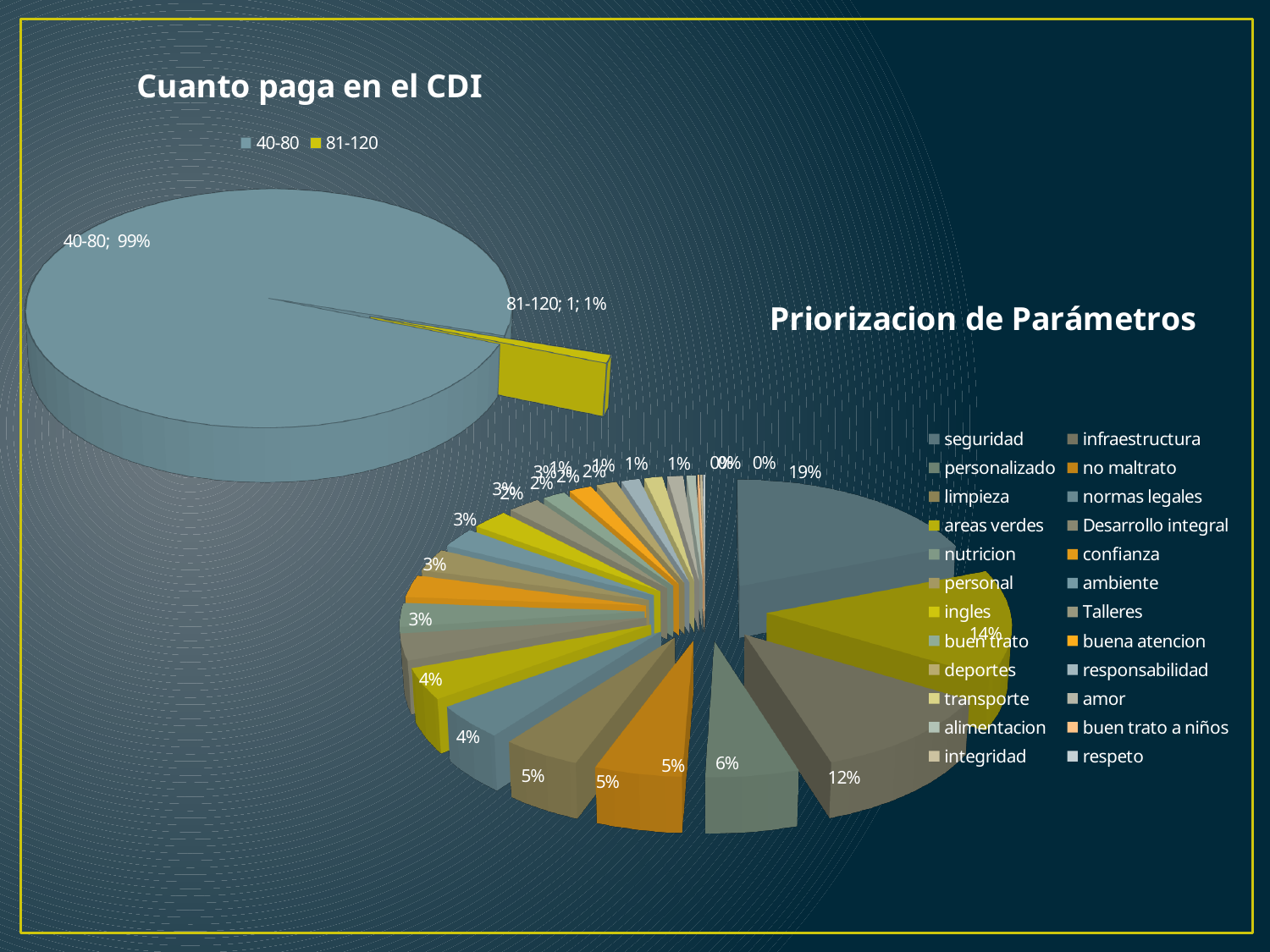
In the 'Cuanto paga en el CDI' chart, what share does the 40-80 slice have? 99% In the 'Cuanto paga en el CDI' chart, what count is shown in the data label for the 81-120 slice? 1 What kind of chart is the 'Cuanto paga en el CDI' chart? pie chart In the 'Priorizacion de Parámetros' chart, what is the share of the second-largest slice? 14% In the 'Priorizacion de Parámetros' chart, what is the share of the largest slice? 19% In the 'Cuanto paga en el CDI' chart, what is the difference in percentage points between the 40-80 and 81-120 slices? 98 percentage points How many entries does the legend of the 'Priorizacion de Parámetros' chart list? 24 What is the title of the chart on the right side of the slide? Priorizacion de Parámetros What kind of chart is the 'Priorizacion de Parámetros' chart? pie chart In the 'Cuanto paga en el CDI' chart, which slice is larger, 40-80 or 81-120? 40-80 How many entries does the legend of the 'Cuanto paga en el CDI' chart list? 2 In the 'Cuanto paga en el CDI' chart, what share does the 81-120 slice have? 1%